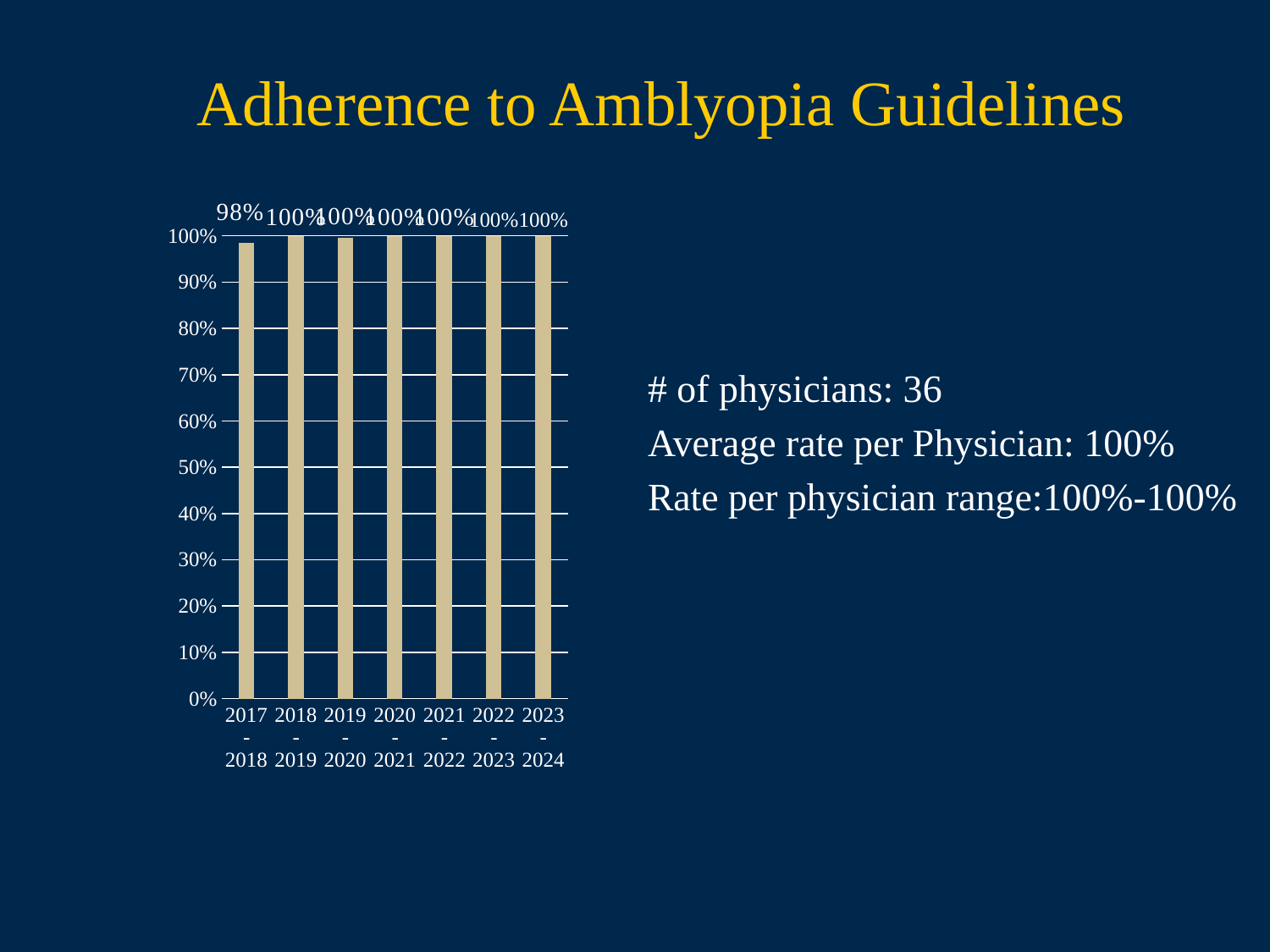
Is the value for 2017-2018 greater or less than 90%? greater What is the value for 2017-2018? 98% Which is larger, the value for 2017-2018 or the value for 2019-2020? 2019-2020 What is the highest value shown on the y axis? 100% How many periods are shown on the x axis? 7 Which period has the lowest value? 2017-2018 What is the value for 2020-2021? 100% What is the value for 2023-2024? 100% What is the difference between the values for 2018-2019 and 2017-2018? 2% What is the title of the slide containing the chart? Adherence to Amblyopia Guidelines What kind of chart is shown on the slide? Bar chart Does the value rise or fall from 2017-2018 to 2018-2019? rise